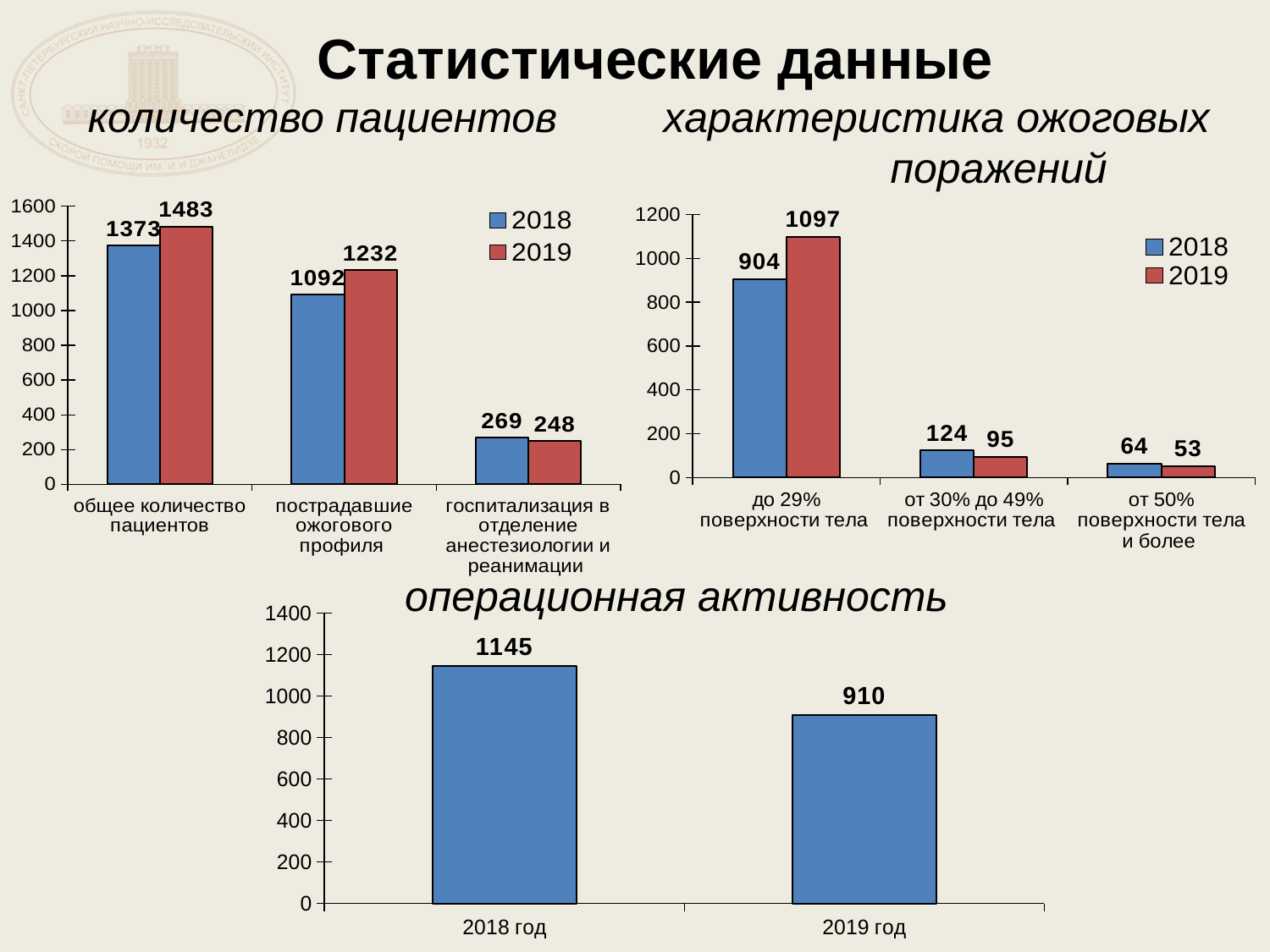
In the 'количество пациентов' chart, what is the difference between the 2018 and 2019 values for 'госпитализация в отделение анестезиологии и реанимации'? 21 In the 'характеристика ожоговых поражений' chart, what is the 2019 value for 'до 29% поверхности тела'? 1097 In the 'количество пациентов' chart, what is the 2019 value for 'общее количество пациентов'? 1483 In the 'характеристика ожоговых поражений' chart, which is larger for 'от 30% до 49% поверхности тела': the 2018 value or the 2019 value? 2018 In the 'операционная активность' chart, what is the value for '2019 год'? 910 In the 'характеристика ожоговых поражений' chart, which category has the lowest 2019 value? от 50% поверхности тела и более In the 'количество пациентов' chart, which colour represents the 2019 series? red In the 'количество пациентов' chart, how many series does the legend list? 2 In the 'операционная активность' chart, what is the difference between the 2018 and 2019 values? 235 What kind of chart is the 'операционная активность' chart? bar chart In the 'характеристика ожоговых поражений' chart, how many categories are shown on the x axis? 3 In the 'количество пациентов' chart, what is the 2018 value for 'пострадавшие ожогового профиля'? 1092